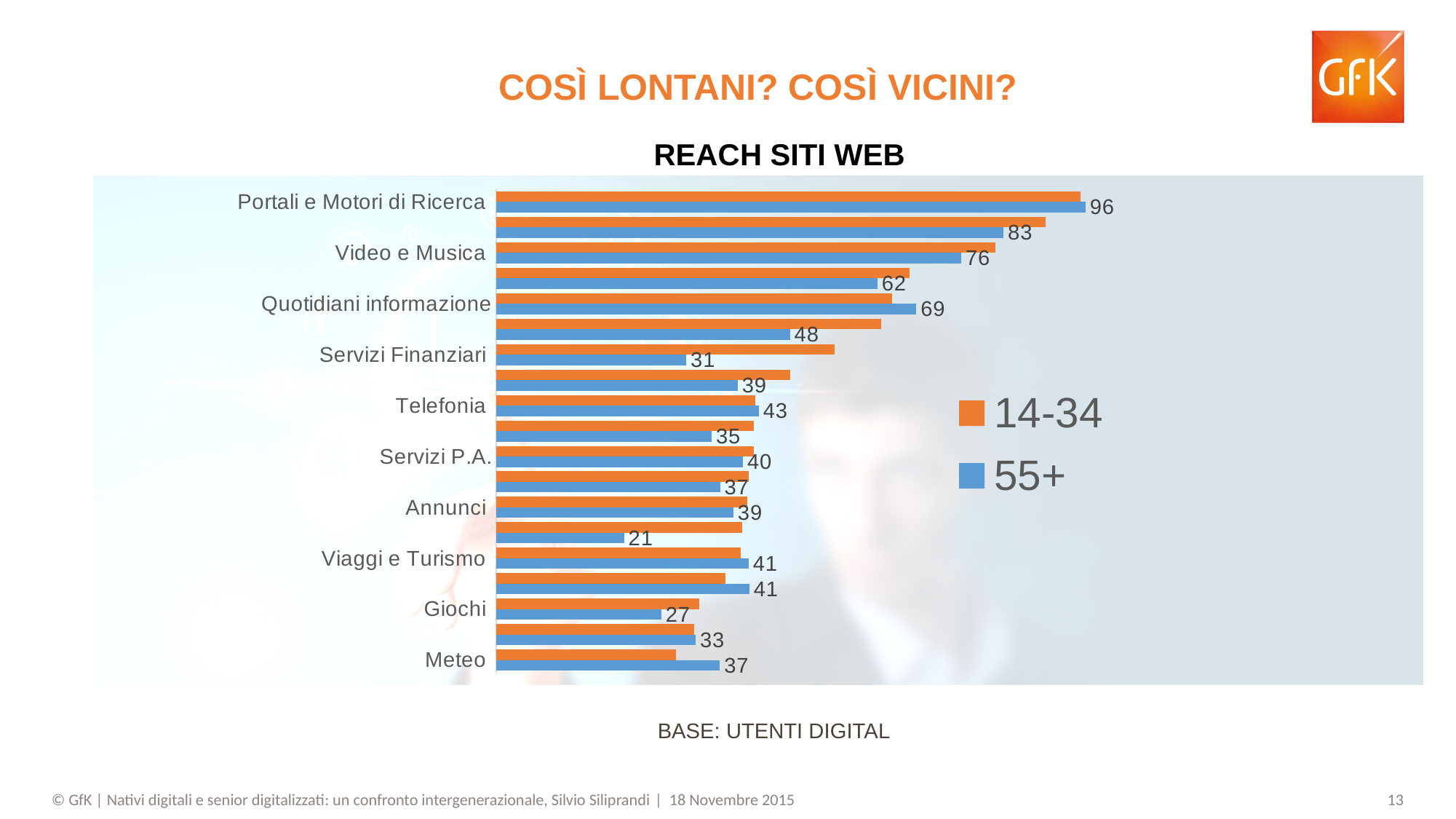
For Meteo, which series has the larger value, 14-34 or 55+? 55+ What is the 55+ value for Giochi? 27 Which colour represents the 14-34 series in the legend? orange What type of chart is shown on the slide? bar chart Which category has the highest 55+ value? Portali e Motori di Ricerca What is the 55+ value for Meteo? 37 What is the 55+ value for Video e Musica? 76 What is the 55+ value for Servizi Finanziari? 31 What is the difference between the 55+ values for Portali e Motori di Ricerca and Meteo? 59 What is the 55+ value for Portali e Motori di Ricerca? 96 For Servizi Finanziari, which series has the larger value, 14-34 or 55+? 14-34 How many series does the legend list? 2